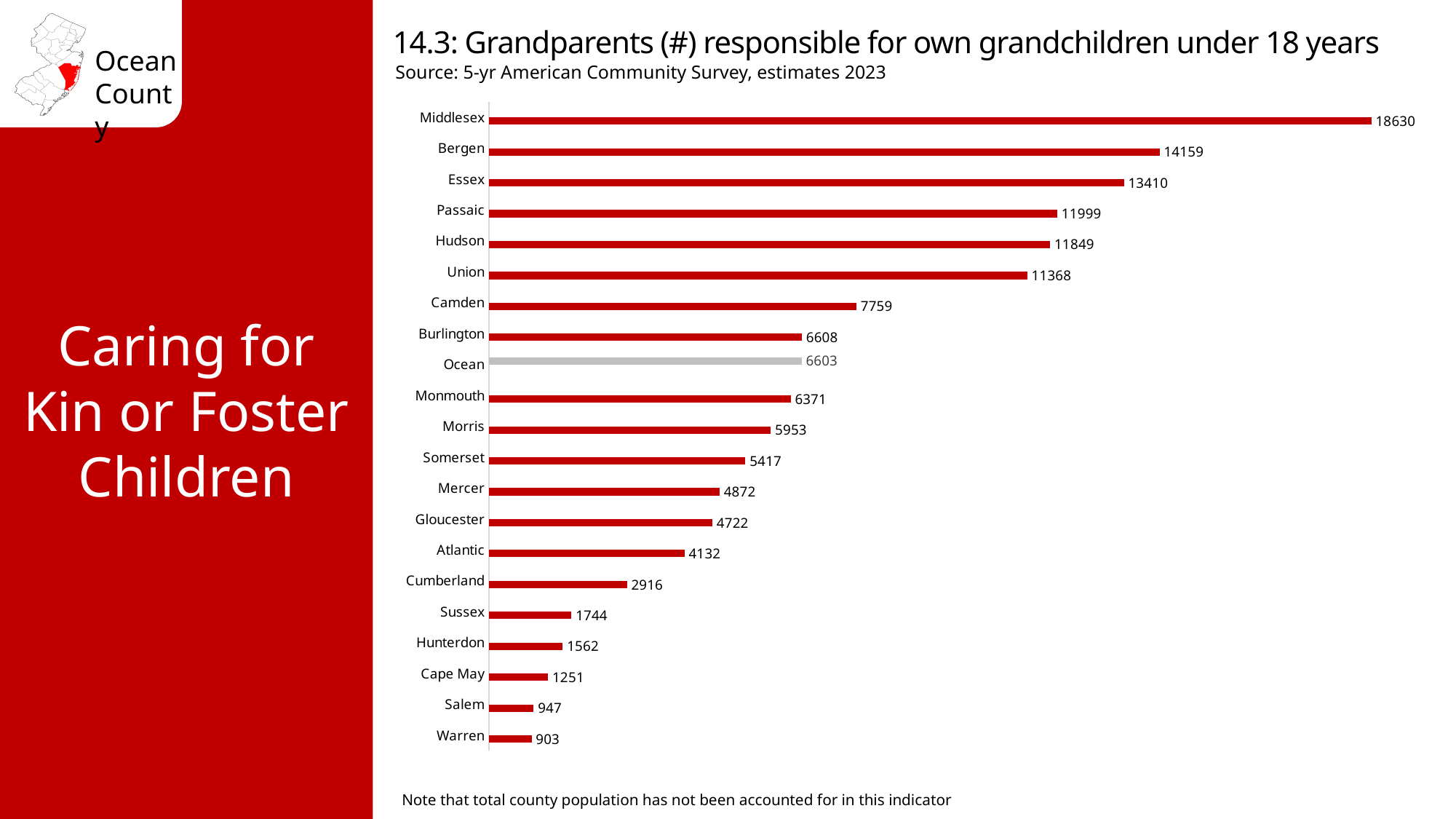
Which has a larger value, Atlantic or Cumberland? Atlantic Which has a larger value, Passaic or Union? Passaic What is the number of grandparents responsible for own grandchildren in Ocean County? 6603 What value is shown for Cape May? 1251 What is the difference between the values for Middlesex and Bergen? 4471 Which county has the highest number of grandparents responsible for own grandchildren? Middlesex What is the difference between the values for Burlington and Ocean? 5 What value is shown for Camden? 7759 Which county's bar is coloured grey instead of red? Ocean How many counties are shown on the chart? 21 What type of chart is shown on the slide? Bar chart Which county has the lowest value on the chart? Warren